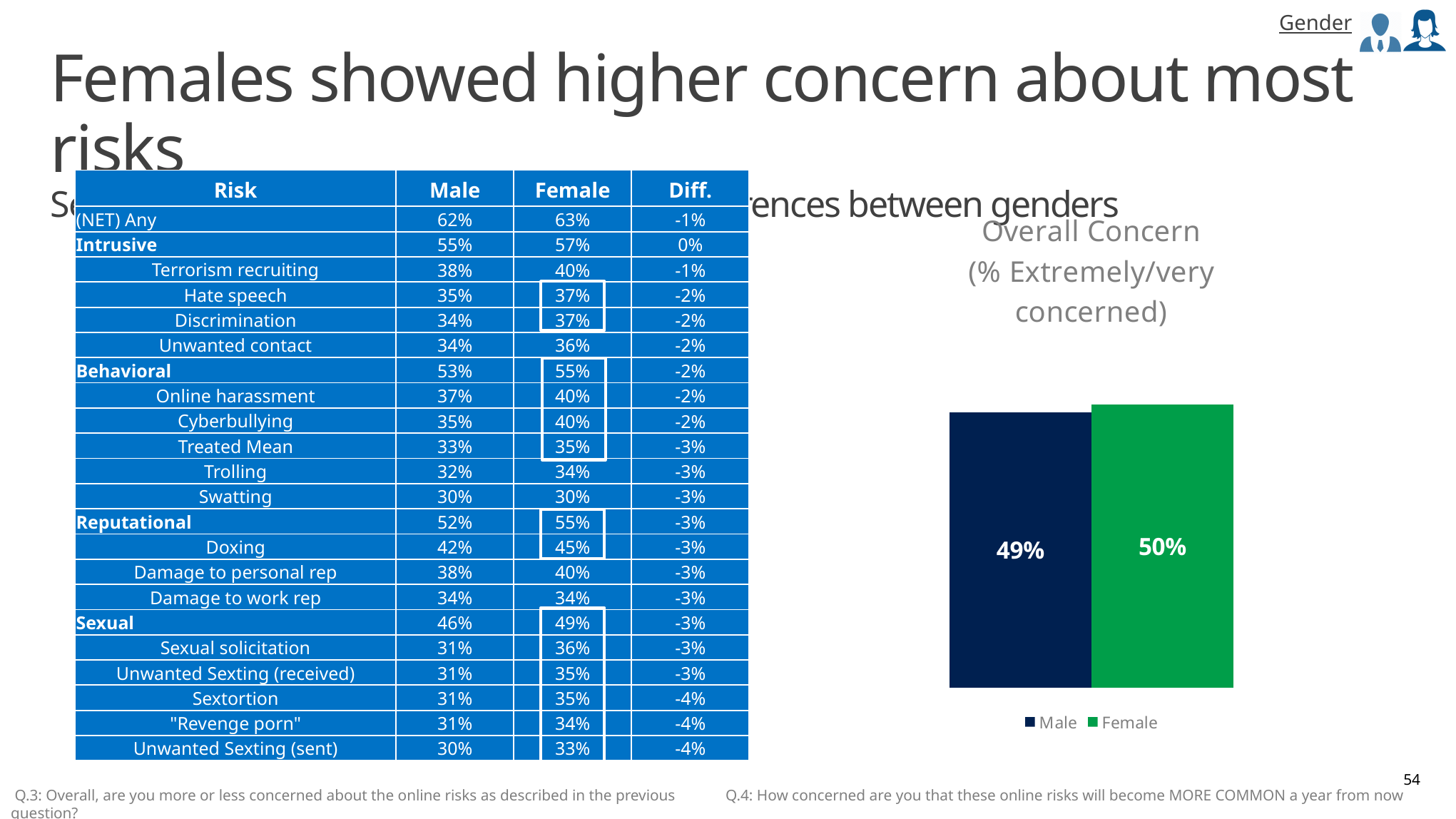
In the Overall Concern chart, what is the value for Male? 49% In the Overall Concern chart, what is the value for Female? 50% In the Overall Concern chart, what is the difference between the Female and Male values? 1% How many series does the legend of the Overall Concern chart list? 2 In the Overall Concern chart, which group has the lower value? Male In the Overall Concern chart, which colour represents Female? green What is the title of the chart on the right side of the slide? Overall Concern (% Extremely/very concerned) In the Overall Concern chart, is the Male value larger or smaller than the Female value? smaller How many bars are plotted in the Overall Concern chart? 2 What kind of chart is the Overall Concern chart? bar chart In the Overall Concern chart, which group has the higher value? Female